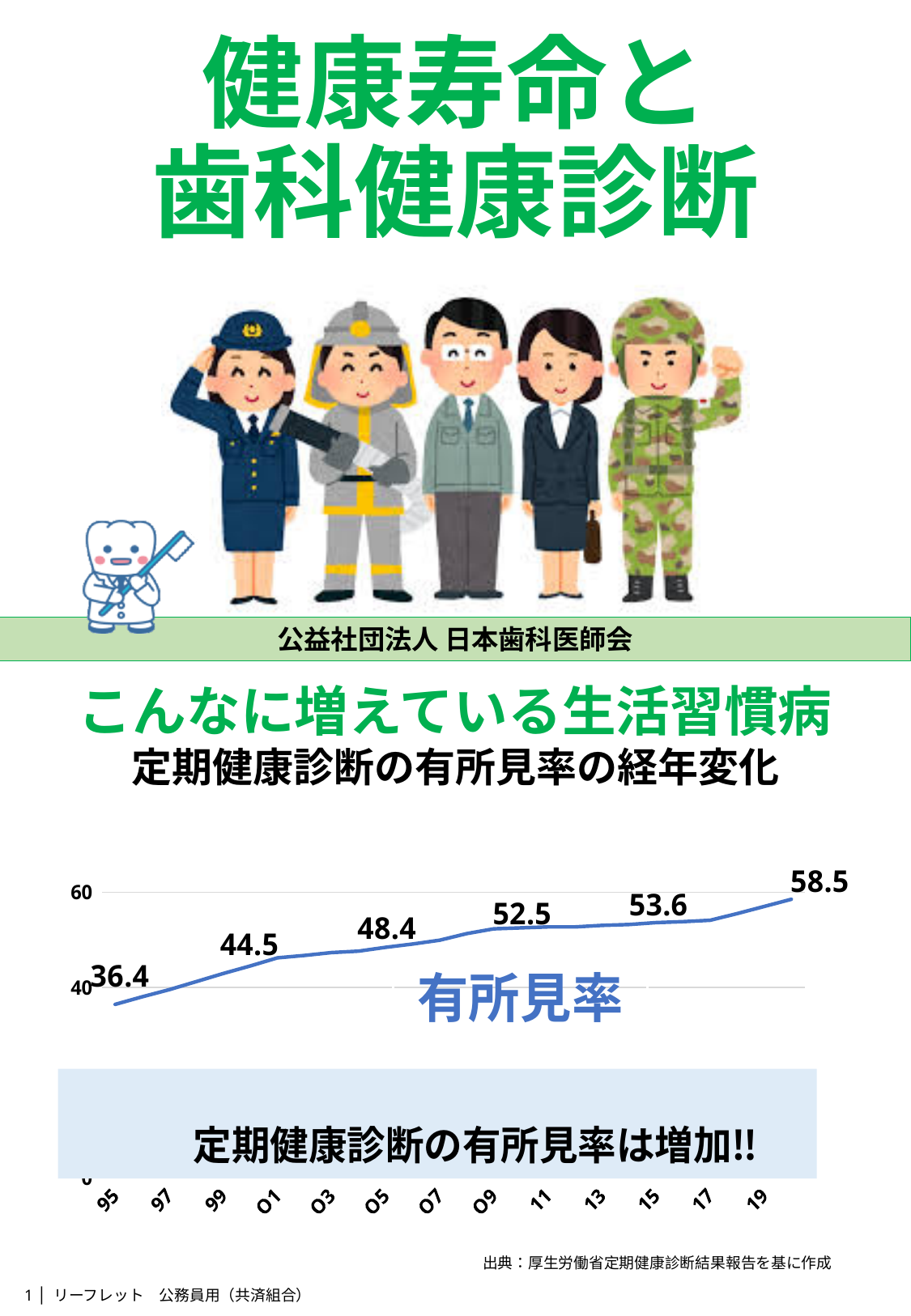
Which is larger, the value at year 95 or the value at year 19? year 19 What is the lowest value labelled on the line chart? 36.4 What is the name of the series shown in large blue text on the chart? 有所見率 What kind of chart is shown on the slide? line chart What is the difference between the last labelled value (58.5) and the first labelled value (36.4)? 22.1 What is the value of the first data point (year 95) on the line chart? 36.4 How many year labels are shown on the x axis? 13 Is the value at year 95 greater or less than 40? less What is the highest value labelled on the line chart? 58.5 How many data labels are printed on the line? 6 What is the value of the last data point (year 19) on the line chart? 58.5 Do the values rise or fall from year 95 to year 19? rise